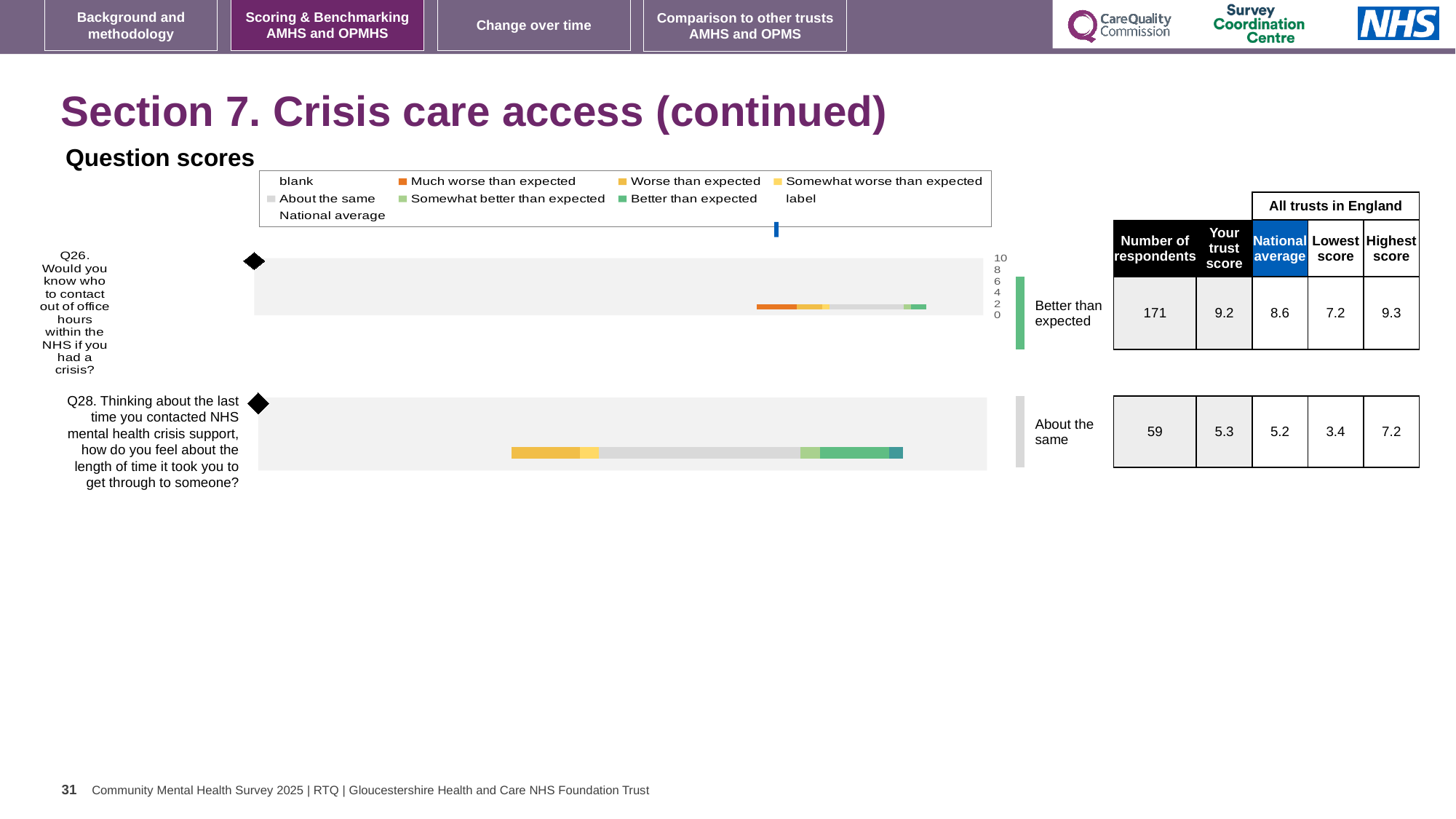
What is the trust score for Q26 (Would you know who to contact out of office hours within the NHS if you had a crisis?)? 9.2 Which question has the higher trust score, Q26 or Q28? Q26 What is the national average score for Q26? 8.6 How many questions are plotted in the question scores chart? 2 What is the trust score for Q28 (length of time it took to get through to someone)? 5.3 What benchmark rating is shown for Q26? Better than expected What kind of chart is used to show the question scores on this slide? bar chart In the chart legend, what colour represents 'Better than expected'? green What is the difference between the highest score (9.3) and the lowest score (7.2) for Q26? 2.1 In the chart legend, what colour represents 'Much worse than expected'? orange Is the trust score for Q26 greater or less than 8? greater How many respondents answered Q28? 59